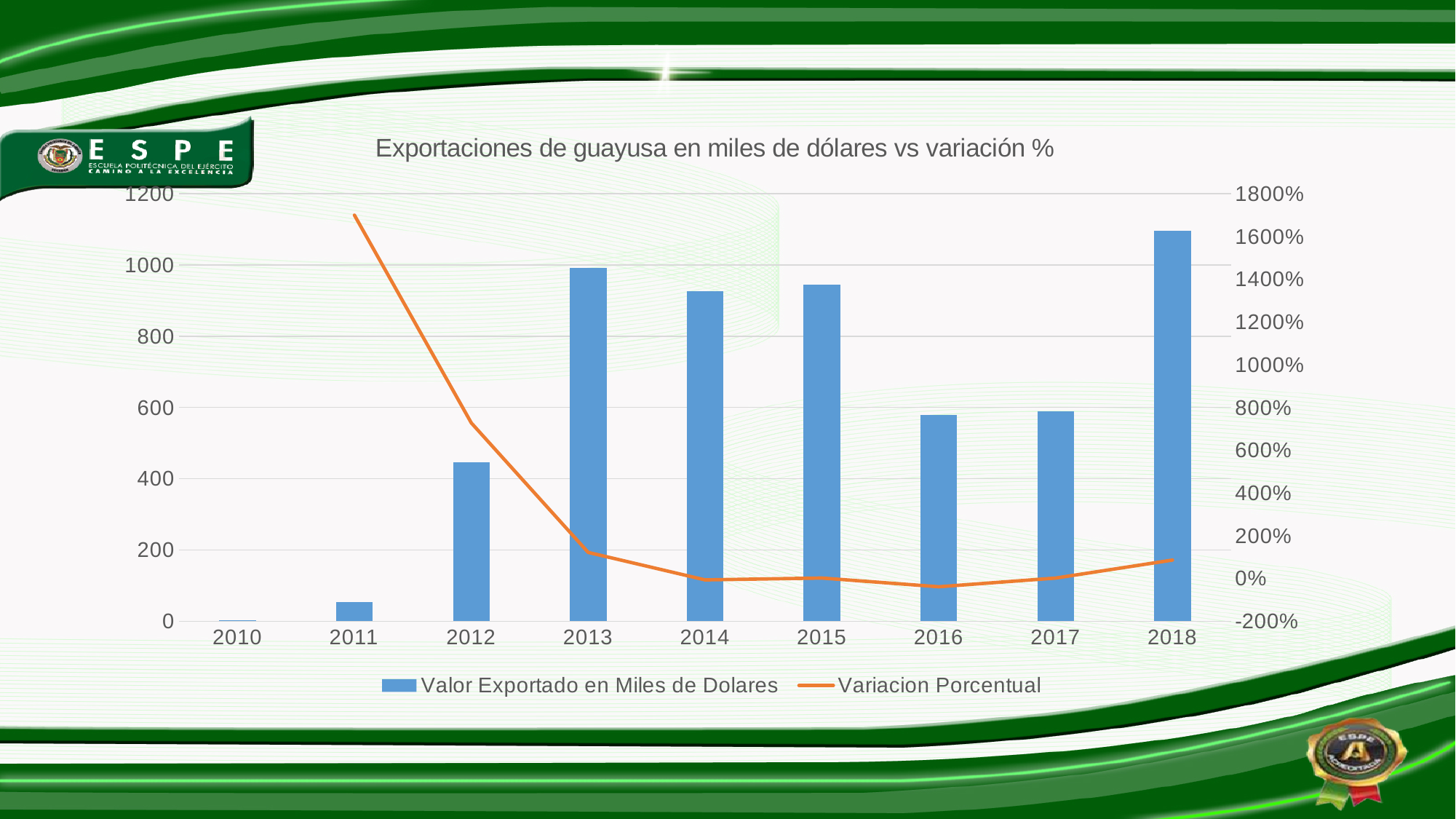
Is the Variacion Porcentual value for 2011 greater or less than 1400%? greater Does the Variacion Porcentual line rise or fall from 2011 to 2014? It falls Which year has the highest bar for Valor Exportado en Miles de Dolares? 2018 Is the Valor Exportado en Miles de Dolares bar for 2012 greater or less than 600? less Which year has the larger Valor Exportado en Miles de Dolares bar, 2013 or 2012? 2013 Is the Valor Exportado en Miles de Dolares bar for 2016 greater or less than 400? greater How many years are shown on the x axis? 9 What kind of chart is shown on the slide? A combined bar and line chart How many series does the legend list? 2 Which year has the lowest bar for Valor Exportado en Miles de Dolares? 2010 What is the title of the chart? Exportaciones de guayusa en miles de dólares vs variación %